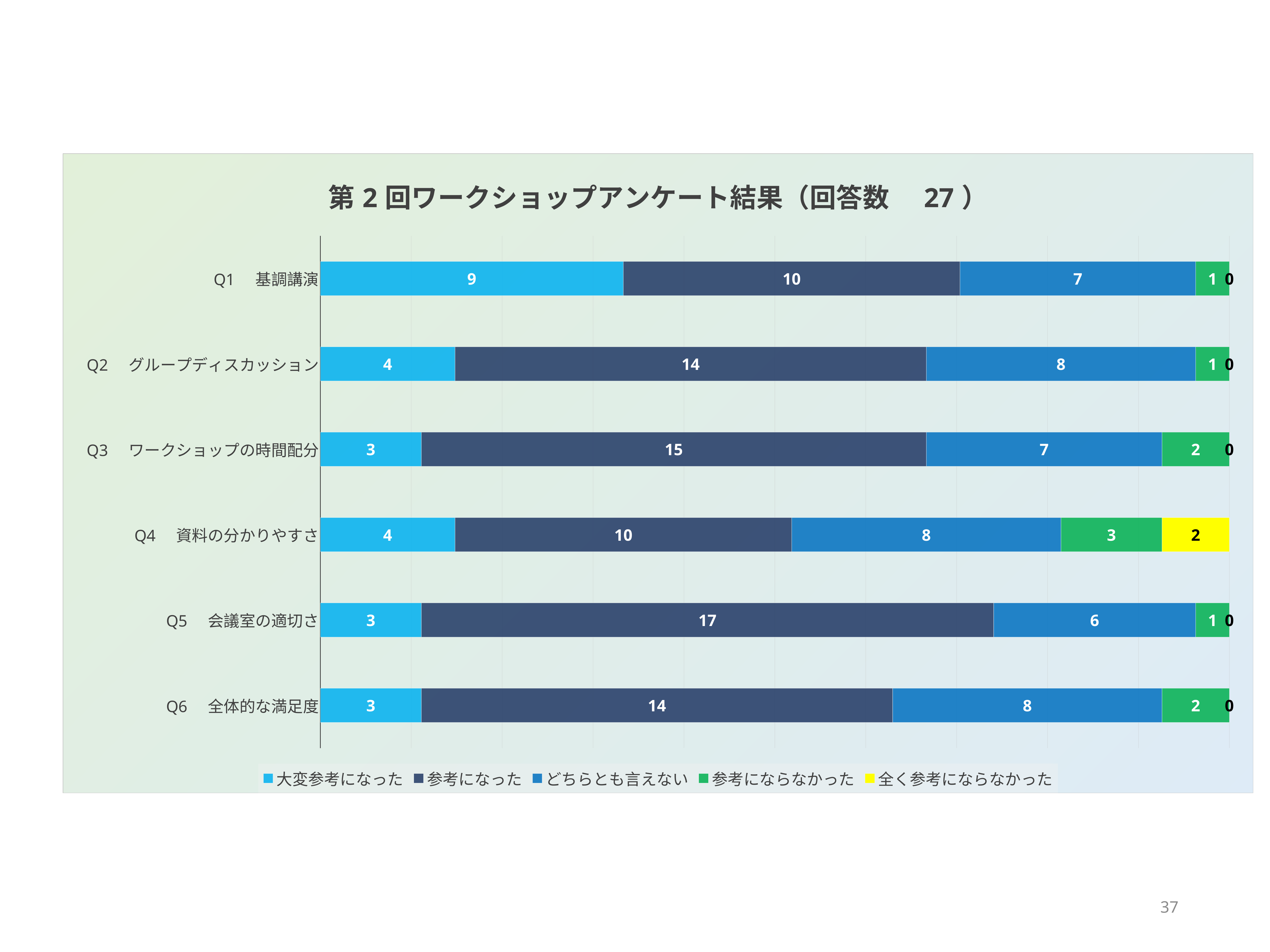
What is the value of 参考になった for Q5 会議室の適切さ? 17 What is the value of 全く参考にならなかった for Q4 資料の分かりやすさ? 2 How many categories (questions) are plotted on the chart? 6 Which category has the highest value for 大変参考になった? Q1 基調講演 How many series does the legend list? 5 What is the total of the stacked bar for Q4 資料の分かりやすさ? 27 What is the difference between the 参考になった values for Q3 ワークショップの時間配分 and Q1 基調講演? 5 Which category has the highest value for 参考になった? Q5 会議室の適切さ What is the value of 大変参考になった for Q1 基調講演? 9 What is the title of the chart? 第２回ワークショップアンケート結果（回答数 27） What type of chart is shown on the slide? Stacked bar chart Which is larger: the どちらとも言えない value for Q2 グループディスカッション or for Q5 会議室の適切さ? Q2 グループディスカッション